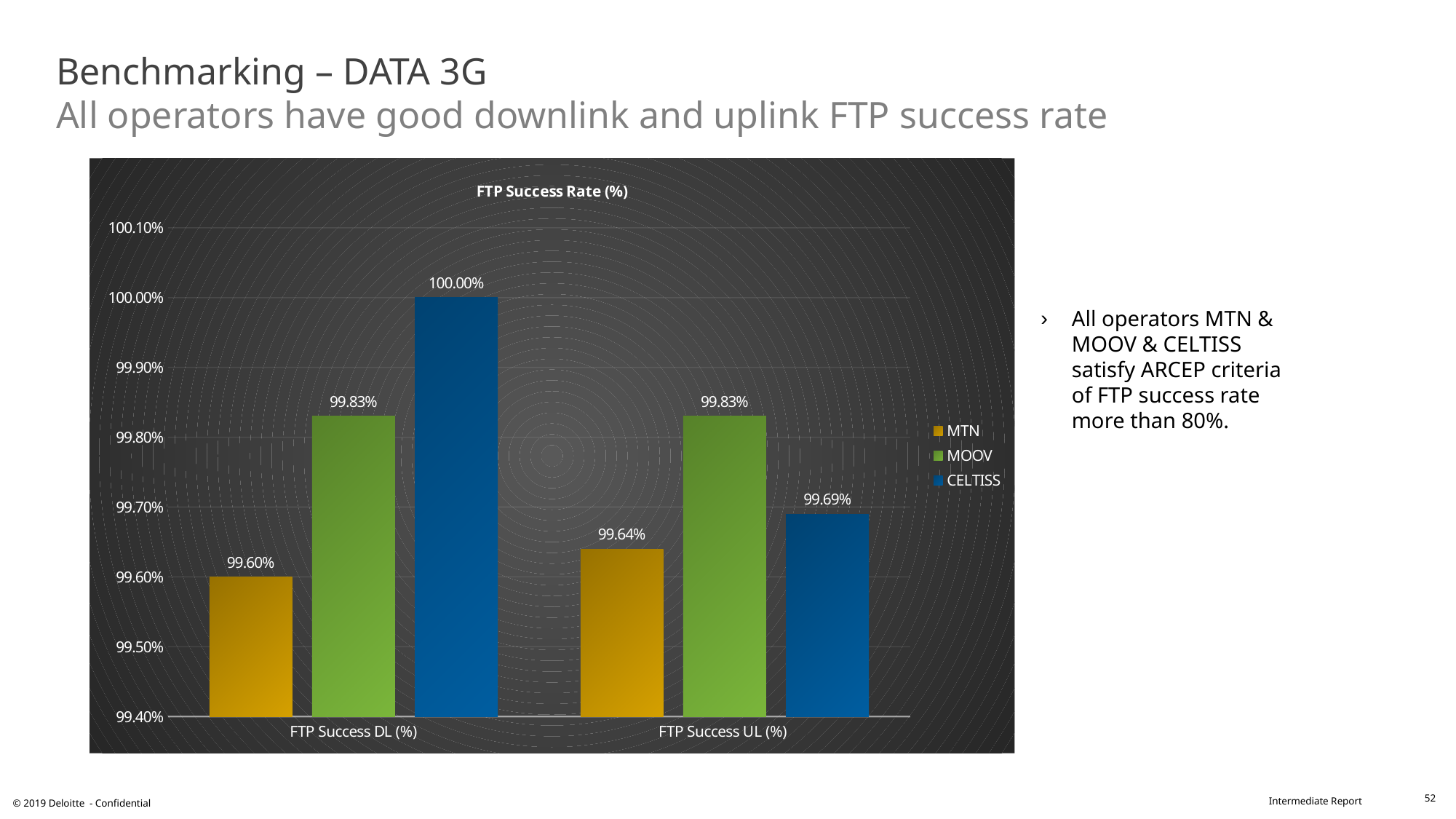
What kind of chart is shown on the slide? Bar chart What is the FTP Success UL (%) value for MOOV? 99.83% What is the FTP Success DL (%) value for CELTISS? 100.00% What is the FTP Success DL (%) value for MTN? 99.60% What is the title of the chart? FTP Success Rate (%) How many categories are shown on the x axis? 2 Which operator has the lowest FTP Success UL (%)? MTN How many series does the legend list? 3 Which is larger: MOOV's FTP Success UL (%) or CELTISS's FTP Success UL (%)? MOOV What is the difference between CELTISS and MTN for FTP Success DL (%)? 0.40% Which operator has the highest FTP Success DL (%)? CELTISS What is the FTP Success UL (%) value for CELTISS? 99.69%